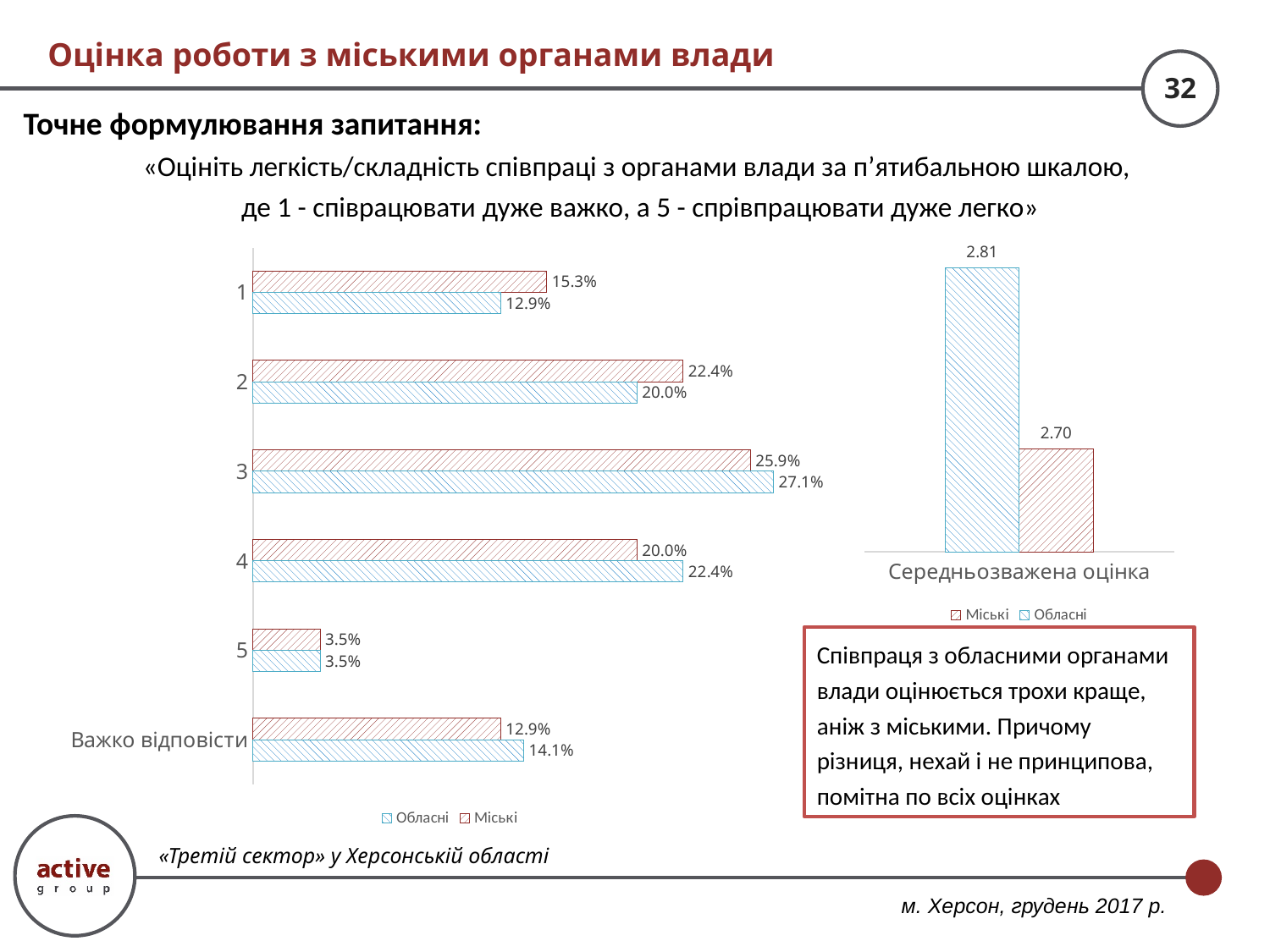
In the right chart titled 'Середньозважена оцінка', what is the difference between the Обласні and Міські values? 0.11 In the left bar chart, what is the value for Міські for category 3? 25.9% In the left bar chart, what is the value for Обласні for 'Важко відповісти'? 14.1% In the left bar chart, what is the difference between the Міські and Обласні values for category 1? 2.4% In the left bar chart, what is the value for Обласні for category 4? 22.4% How many categories are shown in the left bar chart? 6 What type of chart is the right chart titled 'Середньозважена оцінка'? Bar chart In the right chart titled 'Середньозважена оцінка', what is the value for Обласні? 2.81 How many series does the legend of the left bar chart list? 2 In the left bar chart, which category has the lowest value for Міські? 5 In the left bar chart, which is larger for category 2: Міські or Обласні? Міські In the left bar chart, which category has the highest value for Обласні? 3